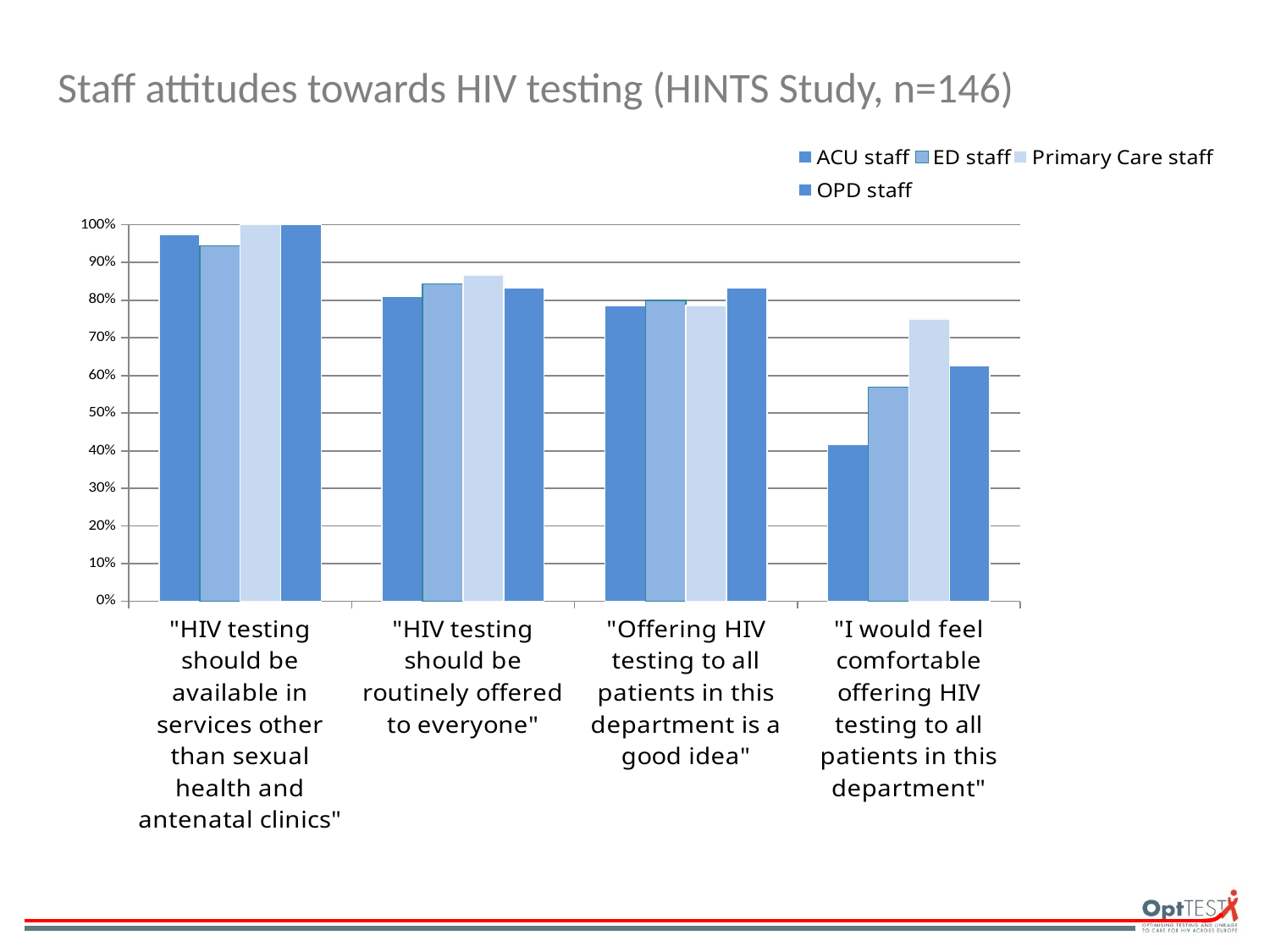
For the statement "I would feel comfortable offering HIV testing to all patients in this department", which staff group has the highest value? Primary Care staff What is the title of the slide? Staff attitudes towards HIV testing (HINTS Study, n=146) Is the value for ACU staff on "I would feel comfortable offering HIV testing to all patients in this department" greater or less than 50%? less Is the value for OPD staff on "Offering HIV testing to all patients in this department is a good idea" greater or less than 90%? less What kind of chart is shown on the slide? Bar chart How many staff groups does the legend list? 4 Is the value for Primary Care staff on "I would feel comfortable offering HIV testing to all patients in this department" greater or less than 70%? greater For "I would feel comfortable offering HIV testing to all patients in this department", which is larger: the value for ED staff or for OPD staff? OPD staff For the statement "I would feel comfortable offering HIV testing to all patients in this department", which staff group has the lowest value? ACU staff How many statements (categories) are shown on the x axis? 4 Do the values for ACU staff rise or fall moving from the first statement to the last statement along the x axis? fall